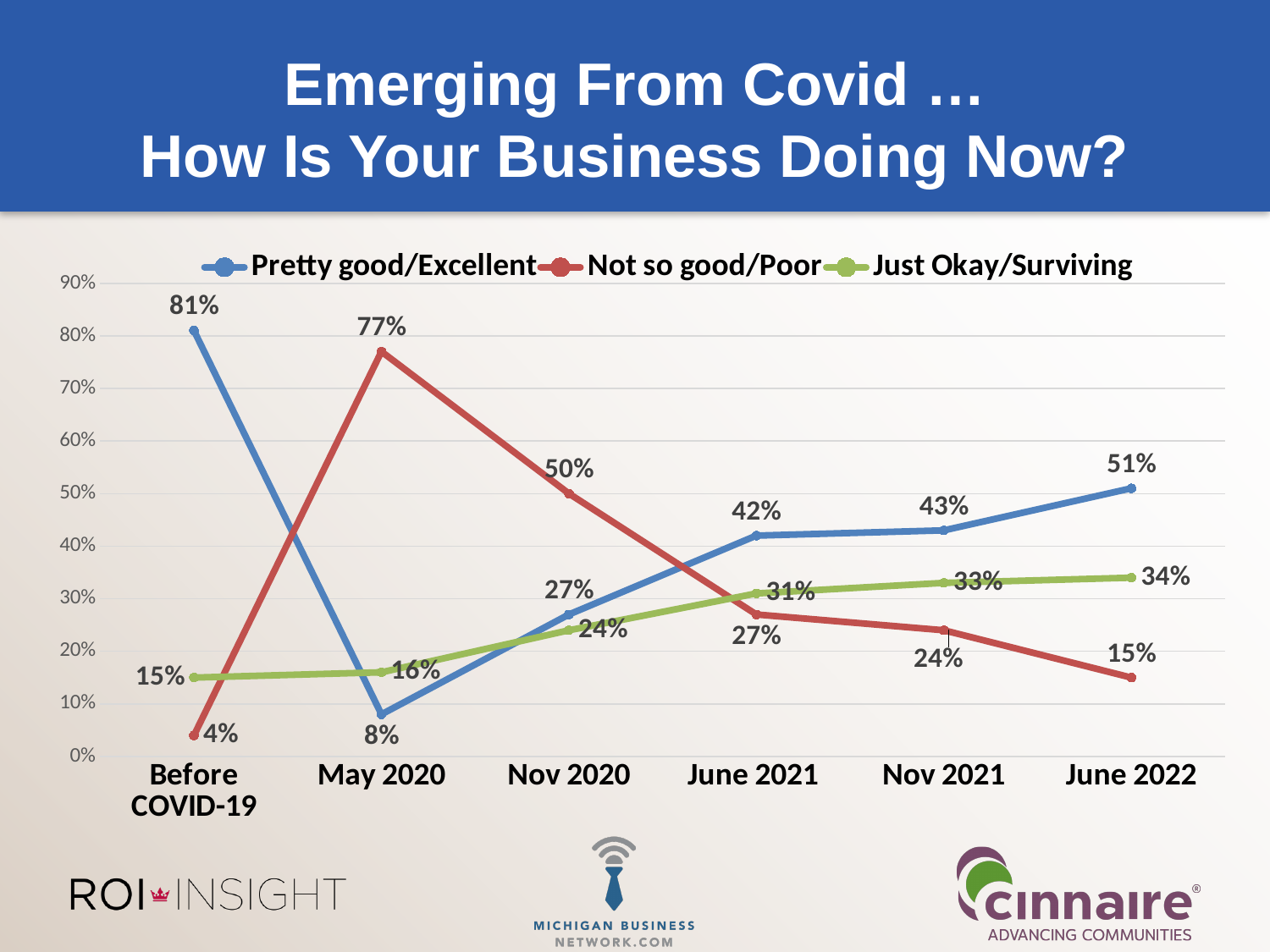
How many series does the legend list? 3 In Nov 2021, which is larger: Pretty good/Excellent or Just Okay/Surviving? Pretty good/Excellent What type of chart is shown on the slide? line chart How many time points are plotted along the x axis? 6 What is the value for Not so good/Poor in May 2020? 77% What is the difference between Pretty good/Excellent and Not so good/Poor in June 2022? 36% At which time point is the Not so good/Poor series highest? May 2020 At which time point is the Pretty good/Excellent series lowest? May 2020 Which colour is used for the Not so good/Poor series? red Does the Just Okay/Surviving series rise or fall from Before COVID-19 to June 2022? rise What is the value for Just Okay/Surviving in June 2022? 34% What is the value for Pretty good/Excellent at Before COVID-19? 81%